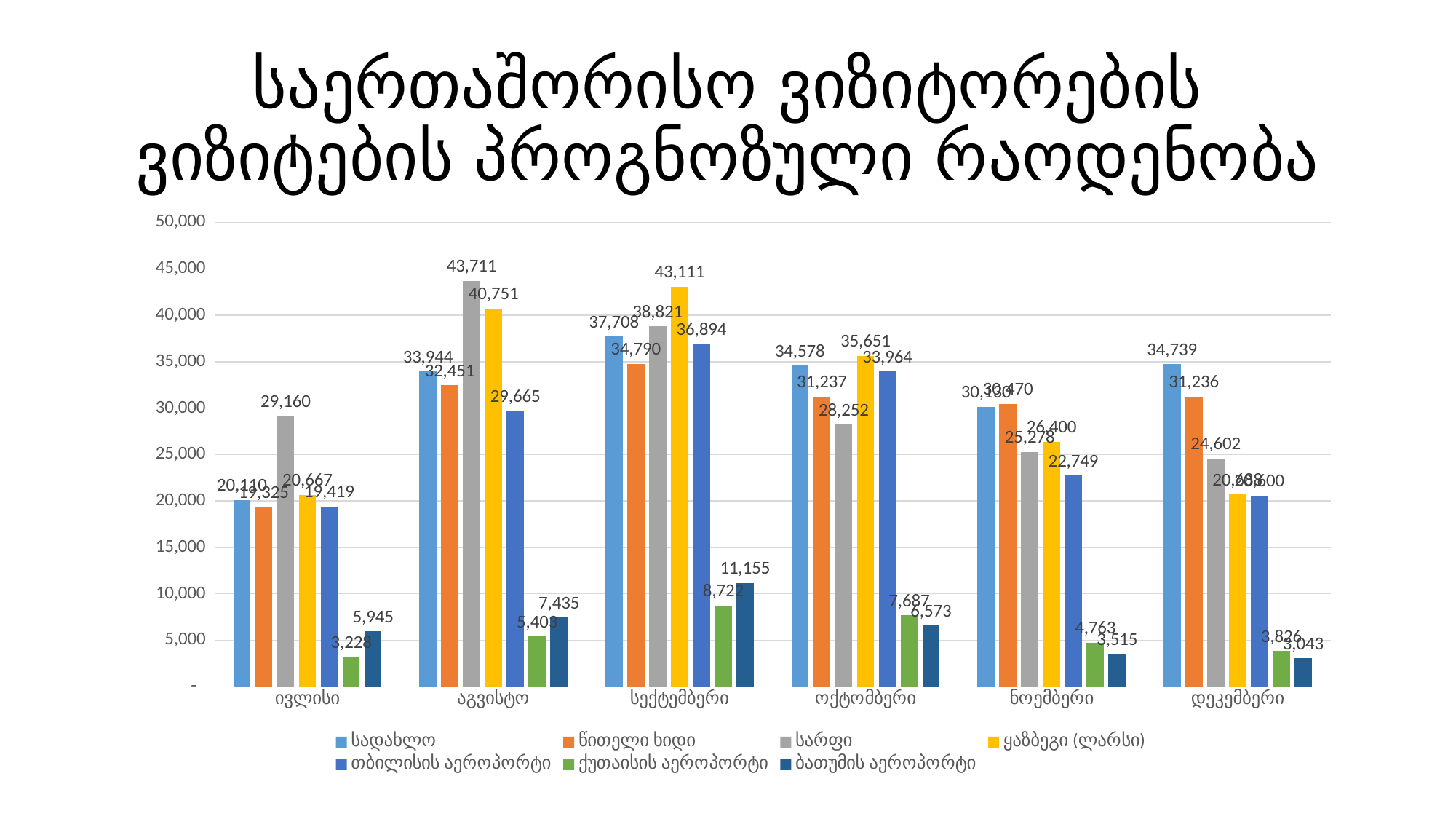
Which series has the highest value in ოქტომბერი? ყაზბეგი (ლარსი) Which series has the lowest value in ნოემბერი? ბათუმის აეროპორტი Does the value for ქუთაისის აეროპორტი rise or fall from სექტემბერი to დეკემბერი? fall Which is larger in სექტემბერი: სადახლო or წითელი ხიდი? სადახლო What type of chart is shown on the slide? bar chart Is the value for თბილისის აეროპორტი in აგვისტო greater or less than 25,000? greater What is the value for ბათუმის აეროპორტი in ივლისი? 5,945 How many series does the legend list? 7 How many month categories are shown on the x axis? 6 What is the difference between სარფი and სადახლო in ივლისი? 9,050 What is the value for სარფი in აგვისტო? 43,711 What is the value for ყაზბეგი (ლარსი) in სექტემბერი? 43,111